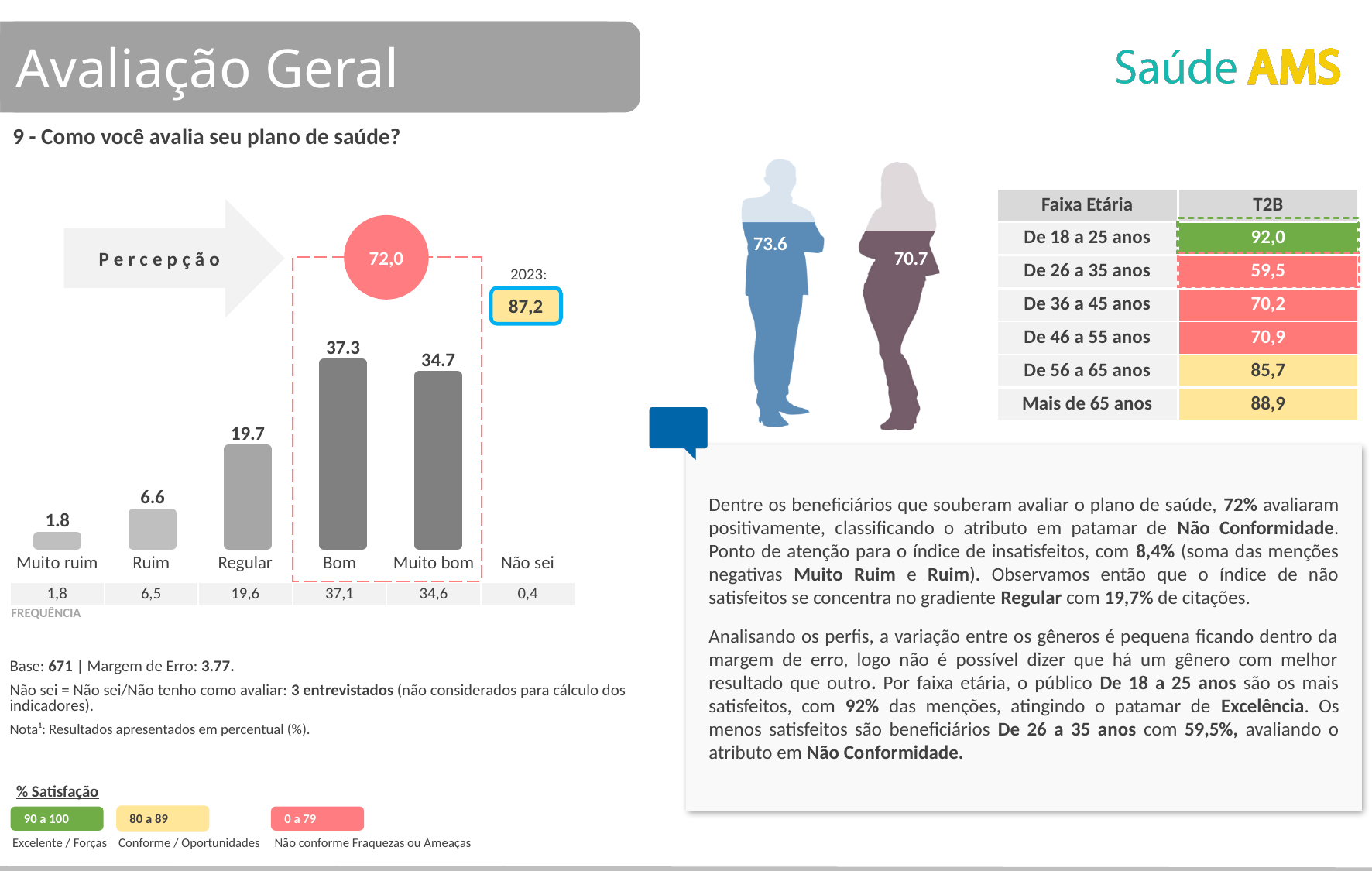
What value is shown in the red circle above the "Bom" and "Muito bom" bars? 72,0 What is the value shown for the "Muito ruim" bar in the bar chart? 1.8 What is the value shown for the "Regular" bar in the bar chart? 19.7 What is the 2023 value shown in the yellow box next to the bar chart? 87,2 What type of chart is used to show the evaluation of the health plan? Bar chart What is the value shown for the "Bom" bar in the bar chart? 37.3 What is the difference between the "Regular" and "Ruim" values in the bar chart? 13.1 Which category has the highest bar in the bar chart? Bom What is the total of the "Bom" and "Muito bom" bar values in the bar chart? 72.0 Which is larger in the bar chart, the value for "Ruim" or the value for "Regular"? Regular Which category with a plotted bar has the lowest value in the bar chart? Muito ruim What is the difference between the "Bom" and "Muito bom" values in the bar chart? 2.6